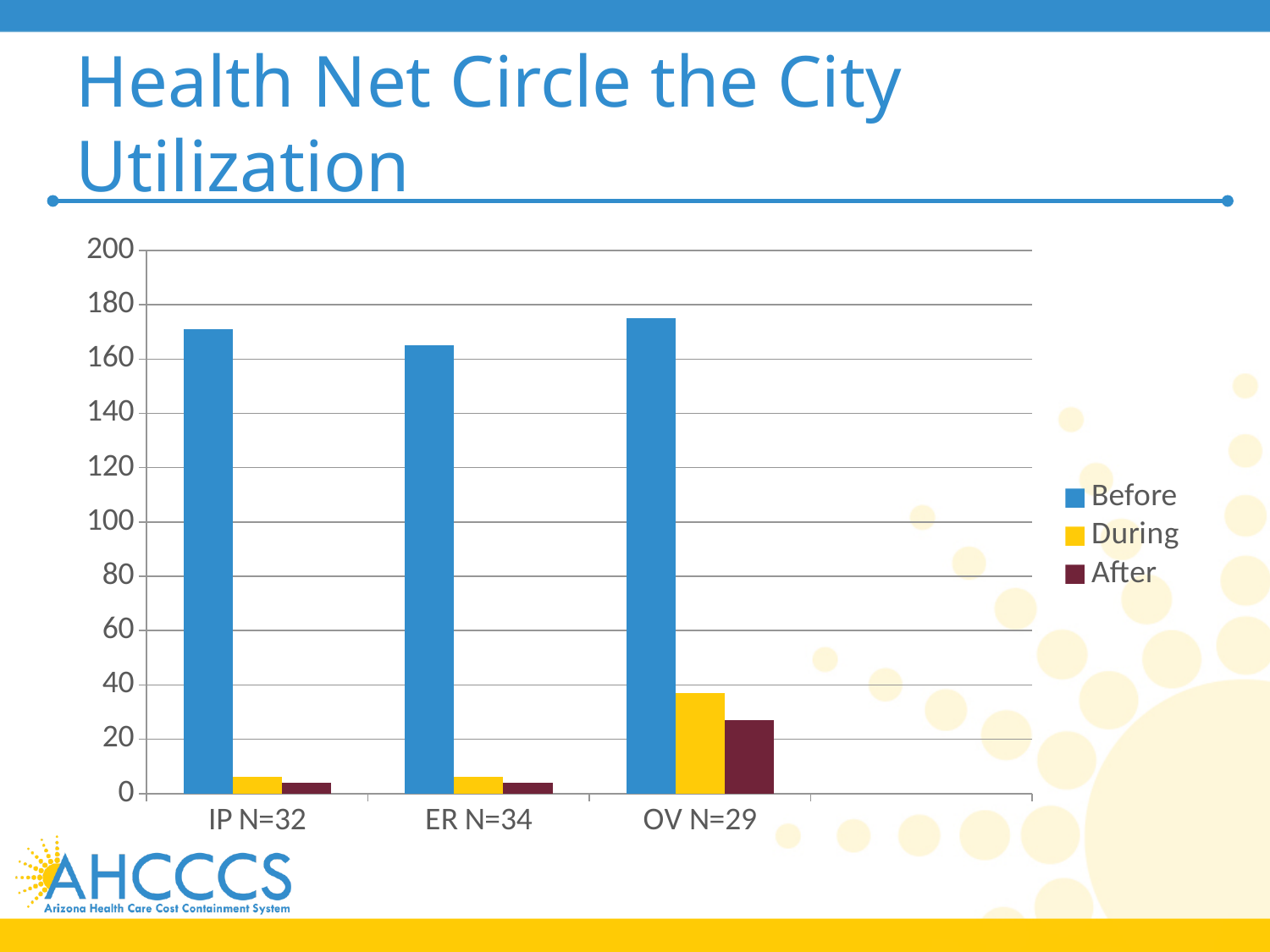
How many categories are shown on the x axis? 3 What is the title of the slide containing the chart? Health Net Circle the City Utilization Which category has the highest After value? OV N=29 What colour represents the During series in the legend? yellow How many series does the legend list? 3 What kind of chart is shown on the slide? bar chart Is the Before value for ER N=34 greater or less than 180? less Which category has the highest During value? OV N=29 Is the After value for IP N=32 greater or less than 20? less Is the During value for OV N=29 greater or less than 20? greater For ER N=34, which is larger, the Before value or the During value? Before